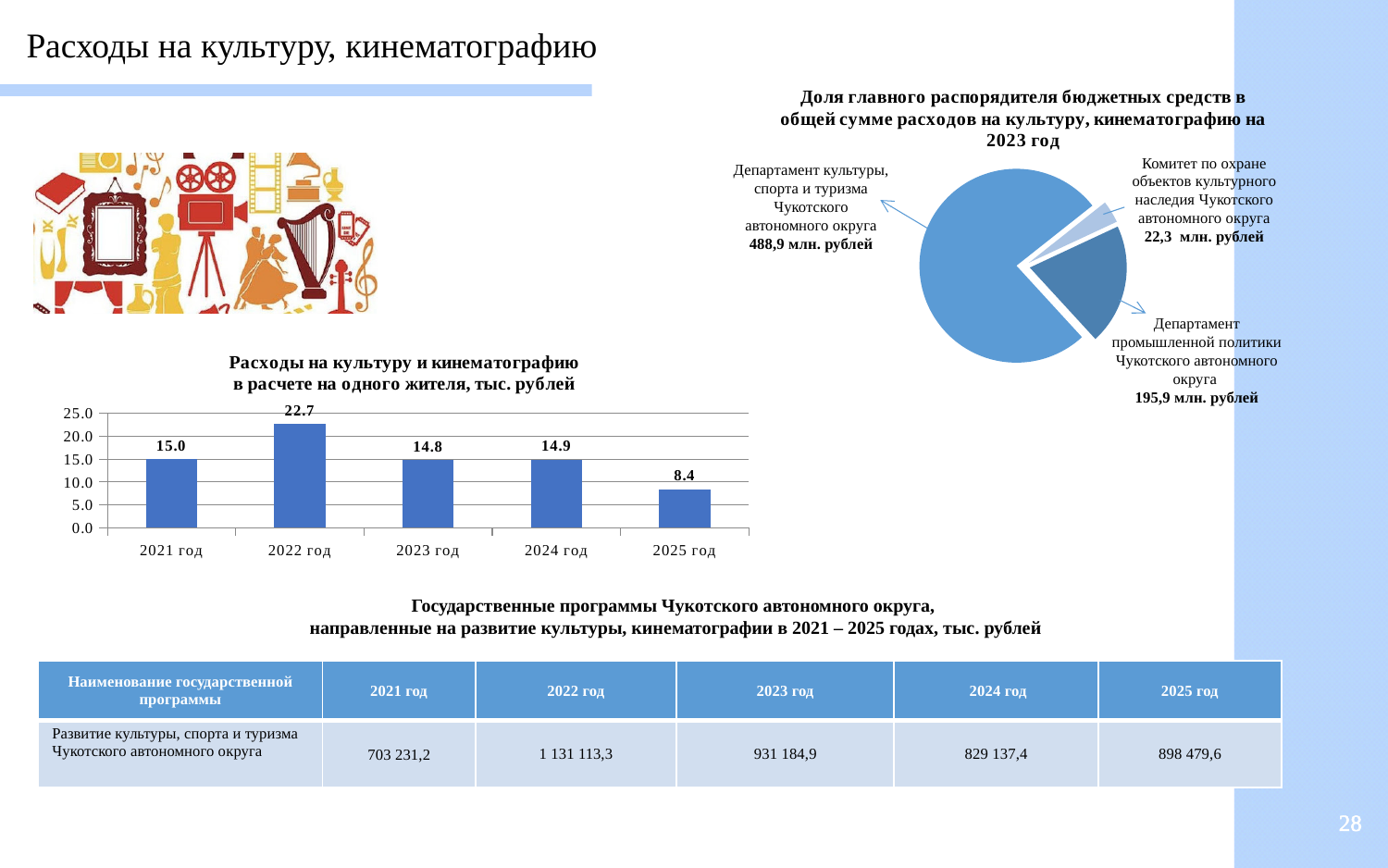
On the bar chart 'Расходы на культуру и кинематографию в расчете на одного жителя, тыс. рублей', what is the value for 2025 год? 8.4 What kind of chart is 'Расходы на культуру и кинематографию в расчете на одного жителя, тыс. рублей'? bar chart On the bar chart 'Расходы на культуру и кинематографию в расчете на одного жителя, тыс. рублей', which year has the lowest value? 2025 год On the pie chart 'Доля главного распорядителя бюджетных средств в общей сумме расходов на культуру, кинематографию на 2023 год', what is the value for Департамент промышленной политики Чукотского автономного округа? 195,9 млн. рублей On the bar chart 'Расходы на культуру и кинематографию в расчете на одного жителя, тыс. рублей', which year has the highest value? 2022 год On the bar chart 'Расходы на культуру и кинематографию в расчете на одного жителя, тыс. рублей', what is the difference between the values for 2022 год and 2021 год? 7.7 On the bar chart 'Расходы на культуру и кинематографию в расчете на одного жителя, тыс. рублей', does the value rise or fall from 2022 год to 2025 год? fall On the bar chart 'Расходы на культуру и кинематографию в расчете на одного жителя, тыс. рублей', which is larger: the value for 2021 год or 2025 год? 2021 год On the bar chart 'Расходы на культуру и кинематографию в расчете на одного жителя, тыс. рублей', what is the value for 2022 год? 22.7 On the bar chart 'Расходы на культуру и кинематографию в расчете на одного жителя, тыс. рублей', how many years are shown? 5 On the pie chart 'Доля главного распорядителя бюджетных средств в общей сумме расходов на культуру, кинематографию на 2023 год', which slice is the smallest? Комитет по охране объектов культурного наследия Чукотского автономного округа What kind of chart is 'Доля главного распорядителя бюджетных средств в общей сумме расходов на культуру, кинематографию на 2023 год'? pie chart